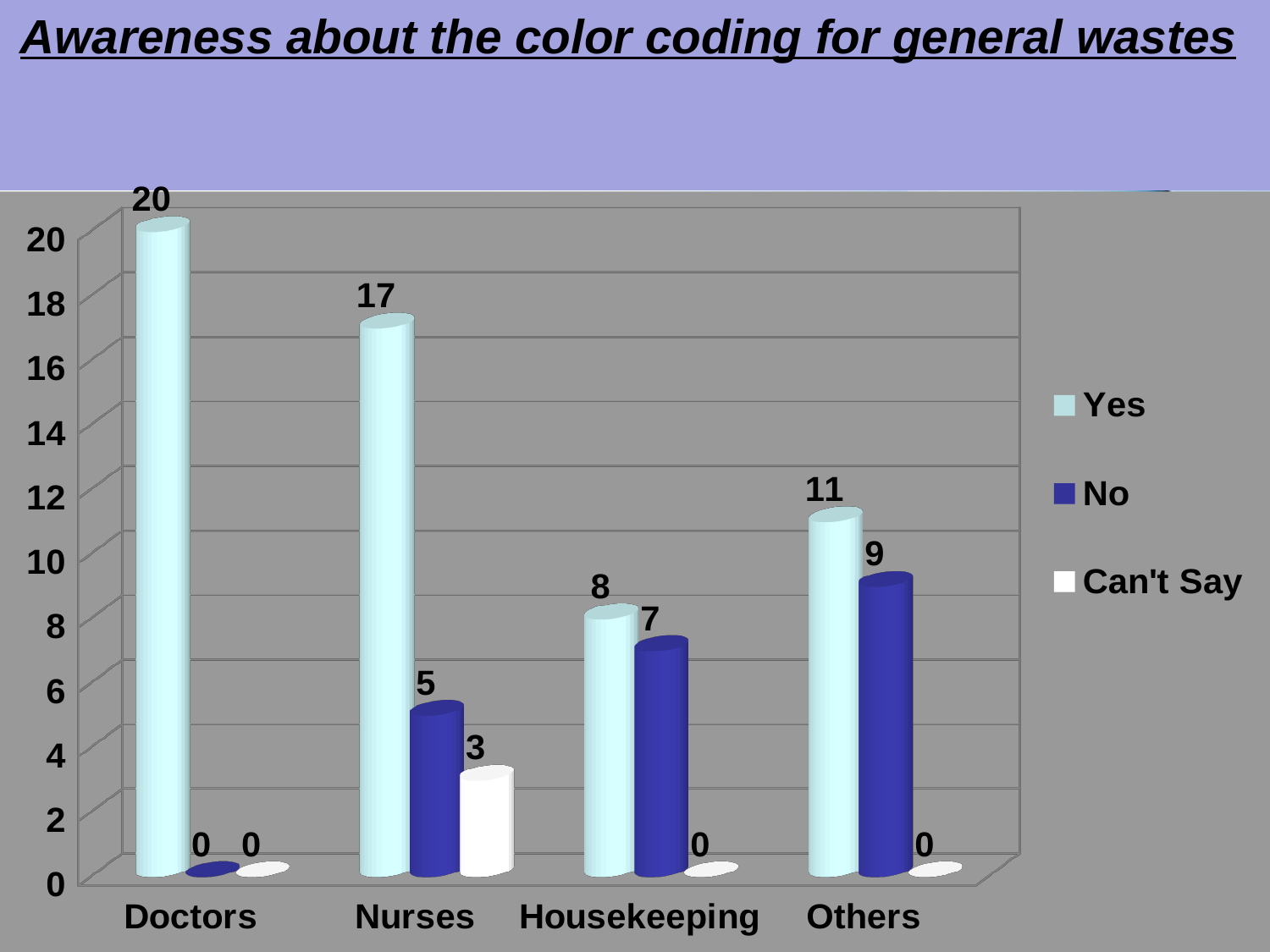
What is the 'No' value for Housekeeping? 7 How many categories are shown on the x axis? 4 What is the total of the 'Yes', 'No' and 'Can't Say' values for Nurses? 25 What is the 'Yes' value for Doctors? 20 What is the title of the chart? Awareness about the color coding for general wastes What kind of chart is shown on the slide? Bar chart How many series does the legend list? 3 What is the 'Can't Say' value for Nurses? 3 What is the difference between the 'Yes' and 'No' values for Others? 2 Which category has the lowest 'Yes' value? Housekeeping Which category has the highest 'Yes' value? Doctors Which is larger for Nurses, the 'Yes' value or the 'No' value? Yes